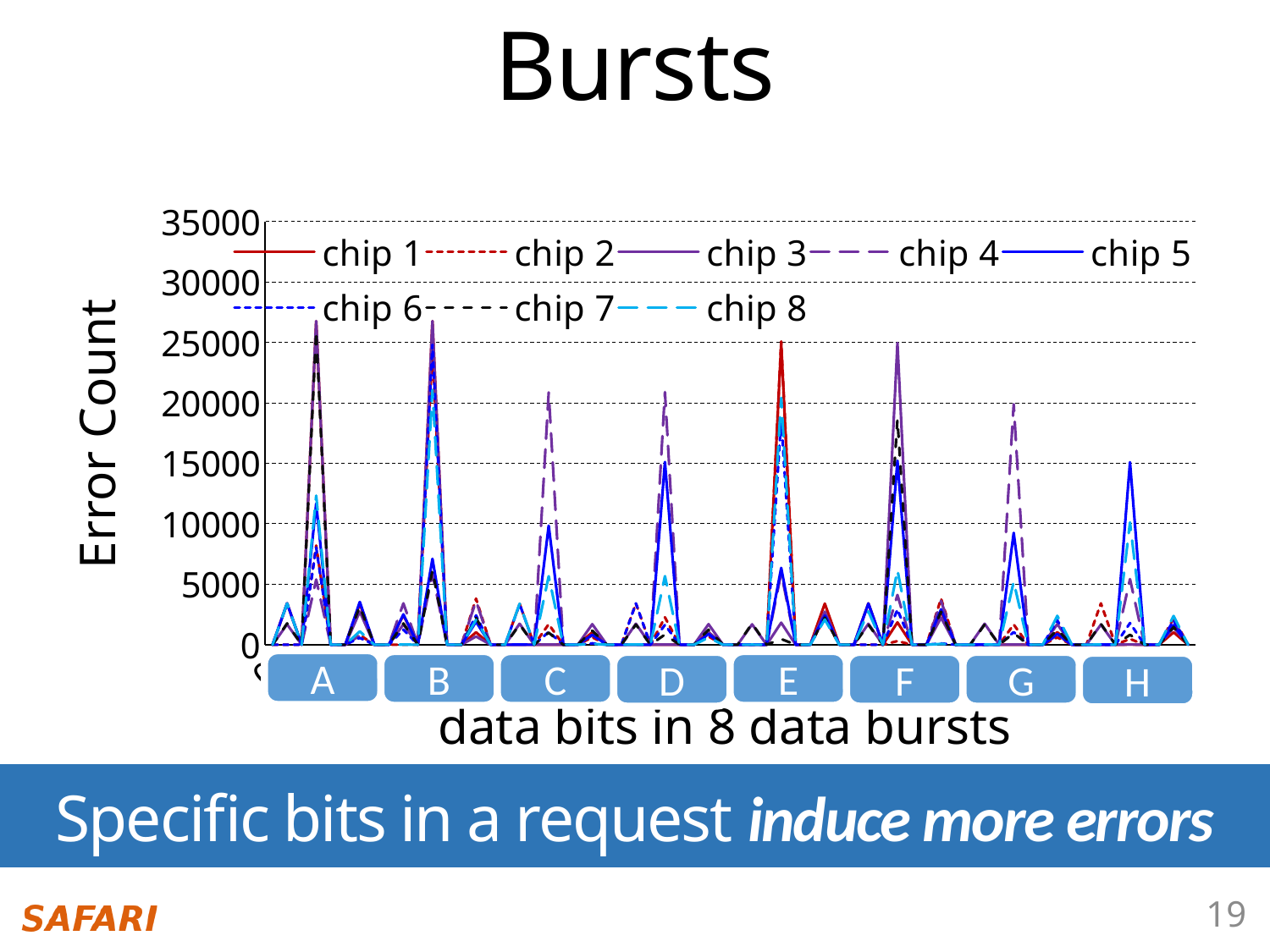
Is the highest peak in burst H greater or less than 20000? less What is the title of the y axis? Error Count What kind of chart is shown on the slide? line chart Is the peak value for chip 5 in burst H greater or less than 10000? greater What is the title of the x axis? data bits in 8 data bursts Which burst has the lowest maximum error count peak? H Is the highest peak in burst C greater or less than 15000? greater How many series does the legend list? 8 How many data bursts (labelled groups) are shown along the x axis? 8